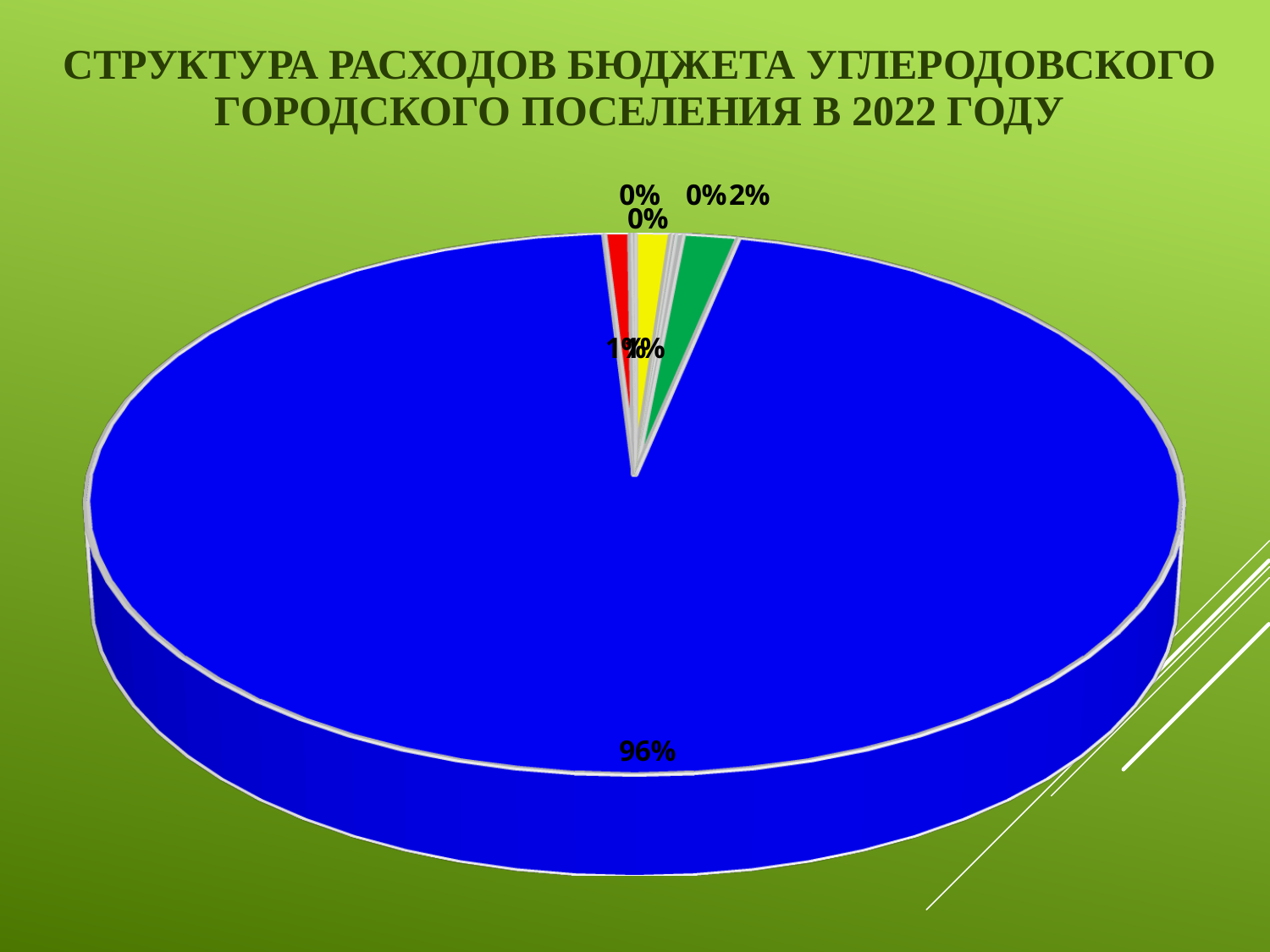
Which year does the chart title refer to? 2022 Which slice is larger, the blue one or the green one? the blue one What is the title of the chart? СТРУКТУРА РАСХОДОВ БЮДЖЕТА УГЛЕРОДОВСКОГО ГОРОДСКОГО ПОСЕЛЕНИЯ В 2022 ГОДУ What share of the pie does the green slice represent? 2% Is the share of the blue slice greater or less than 50%? greater Which colour is the largest slice of the pie? blue What share of the pie does the largest slice (blue) represent? 96% What is the difference between the share of the blue slice and the share of the green slice? 94% What kind of chart is shown on the slide? pie chart